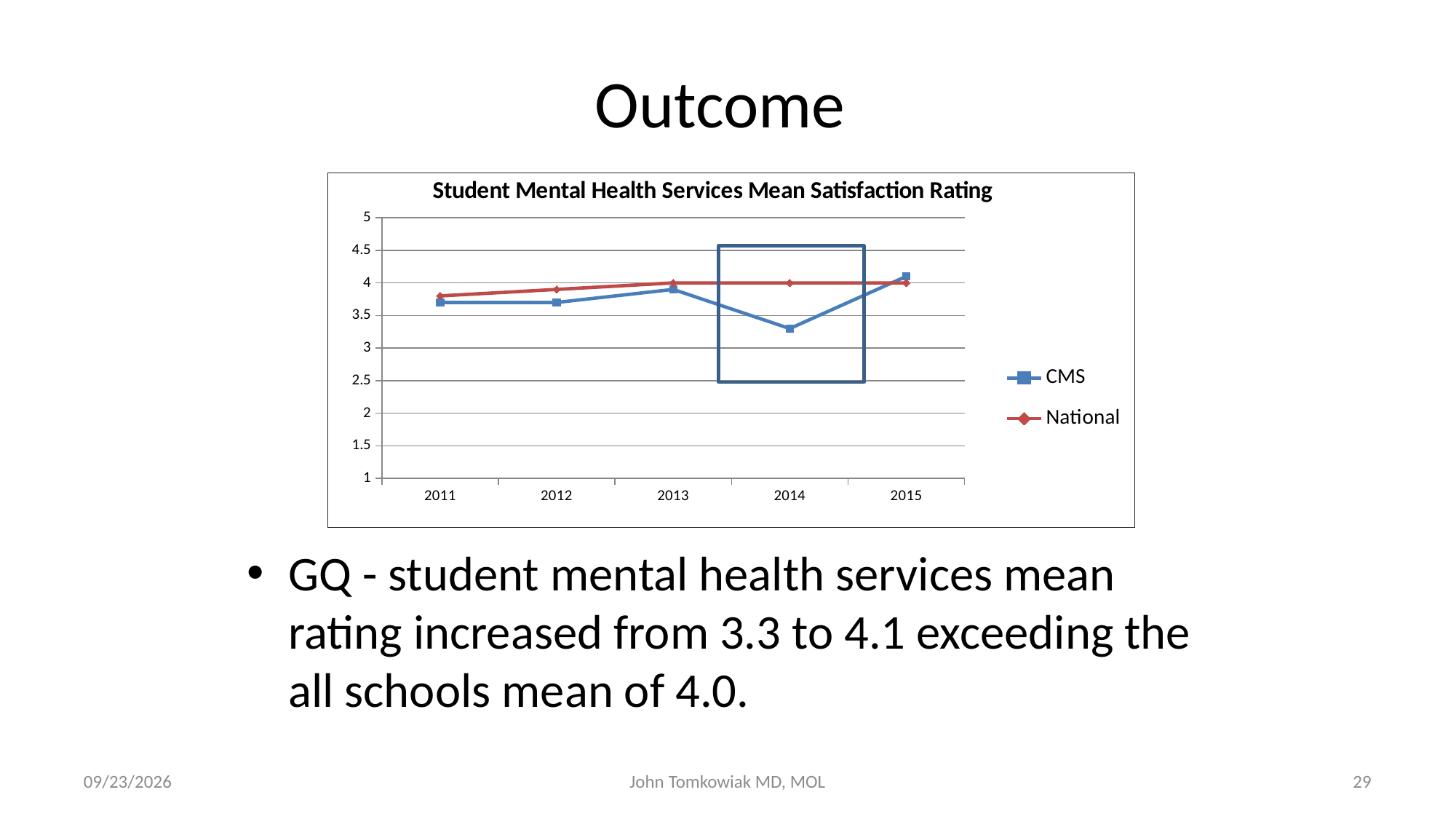
Is the National value for 2011 greater or less than 4? less In which year is the CMS rating lowest? 2014 In which year is the CMS rating highest? 2015 How many series does the chart's legend list? 2 What type of chart is shown on the slide? Line chart Is the CMS value for 2014 greater or less than 3.5? less What is the title of the chart? Student Mental Health Services Mean Satisfaction Rating In 2014, which series has the higher rating, CMS or National? National How many years are shown on the x axis? 5 Is the CMS value for 2015 greater or less than 4? greater Which two series are listed in the legend? CMS and National Does the CMS rating rise or fall from 2014 to 2015? Rise